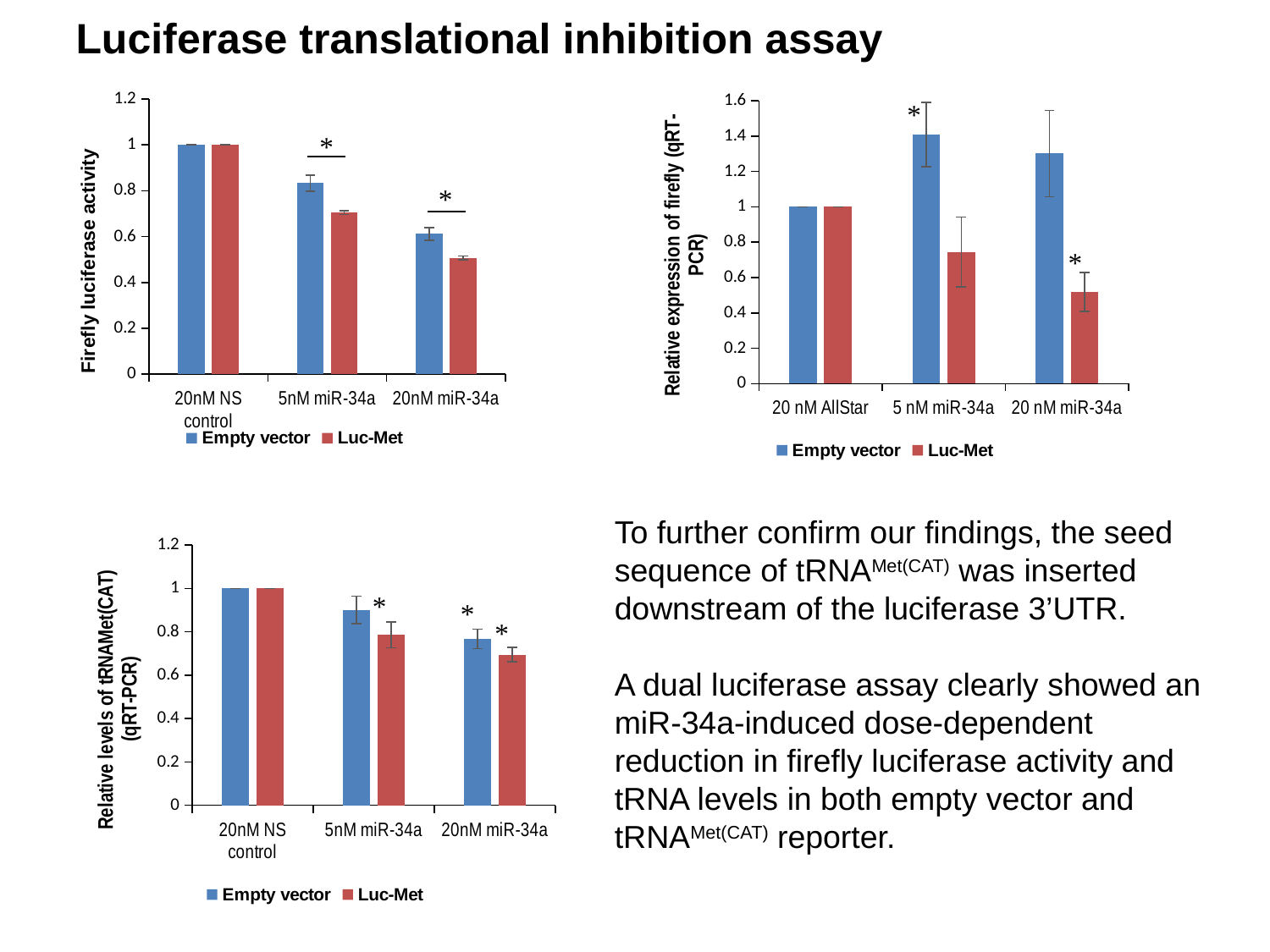
In the bottom-left 'Relative levels of tRNAMet(CAT) (qRT-PCR)' chart, what is the value for Luc-Met at 20nM NS control? 1 How many categories are shown on the x-axis of the top-right 'Relative expression of firefly (qRT-PCR)' chart? 3 In the top-right 'Relative expression of firefly (qRT-PCR)' chart, is the value for Empty vector at 5 nM miR-34a greater or less than 1.2? greater In the top-left 'Firefly luciferase activity' chart, do the Luc-Met values rise or fall from 20nM NS control to 20nM miR-34a? fall What kind of chart is the top-left chart with the y-axis 'Firefly luciferase activity'? bar chart In the top-left 'Firefly luciferase activity' chart, which is larger at 5nM miR-34a: Empty vector or Luc-Met? Empty vector In the top-left 'Firefly luciferase activity' chart, is the value for Luc-Met at 20nM miR-34a greater or less than 0.6? less How many series does the legend of the bottom-left 'Relative levels of tRNAMet(CAT) (qRT-PCR)' chart list? 2 In the top-left 'Firefly luciferase activity' chart, what is the value for Empty vector at 20nM NS control? 1 In the top-right 'Relative expression of firefly (qRT-PCR)' chart, is the value for Luc-Met at 20 nM miR-34a greater or less than 0.8? less What are the two legend entries in the bottom-left 'Relative levels of tRNAMet(CAT) (qRT-PCR)' chart? Empty vector and Luc-Met In the top-left 'Firefly luciferase activity' chart, which bar is the lowest? Luc-Met at 20nM miR-34a